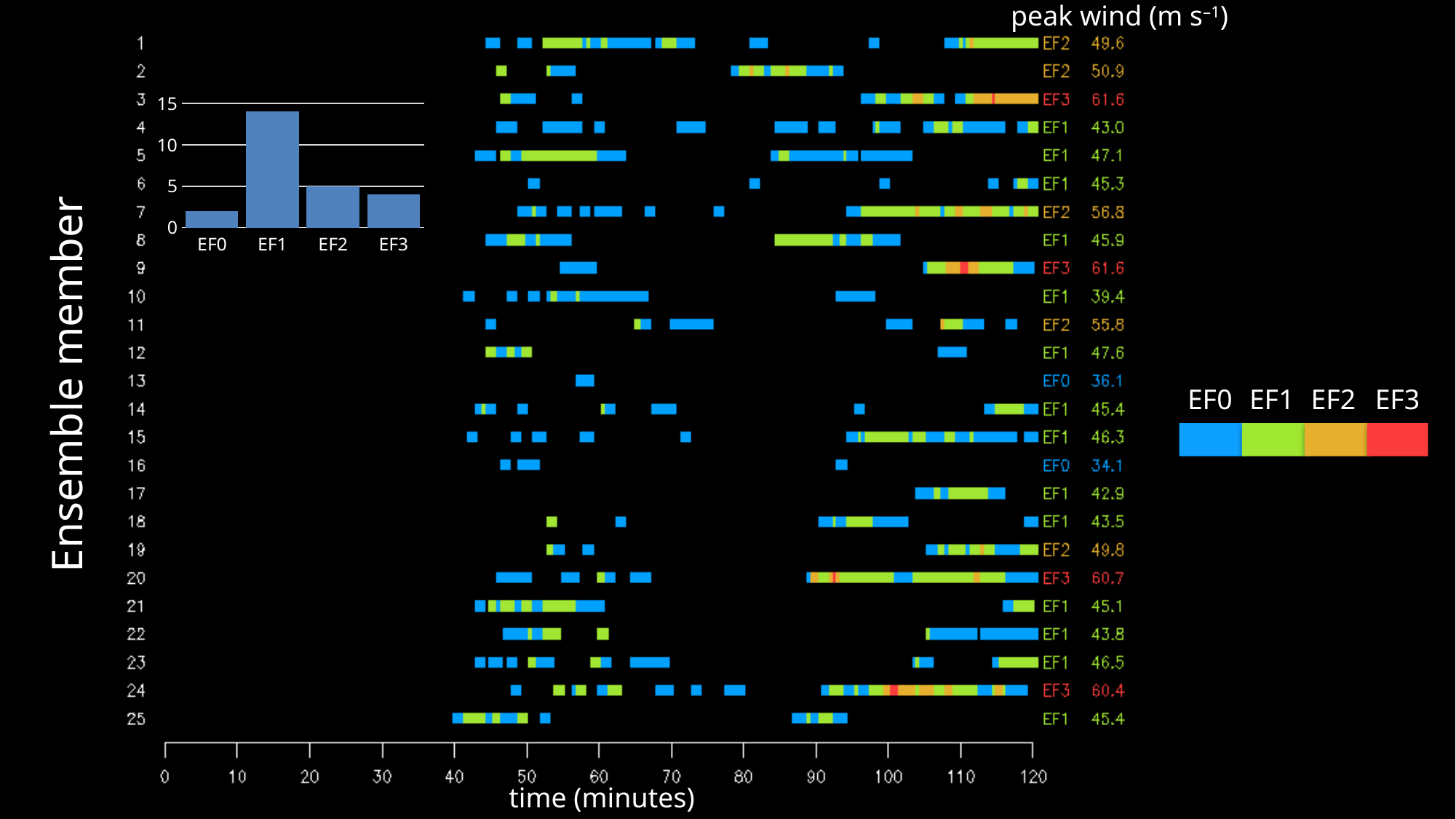
In the inset bar chart, how many categories are shown on the x axis? 4 In the main timeline chart, which ensemble member has the lowest peak wind? 16 In the main timeline chart, how many ensemble members are plotted on the y axis? 25 In the main timeline chart, what EF rating is listed for ensemble member 20? EF3 In the inset bar chart, which EF category has the tallest bar? EF1 What kind of chart is the small inset chart at the top left of the slide? bar chart In the inset bar chart, is the value for EF1 greater or less than 10? greater In the main timeline chart, what is the difference in peak wind between ensemble member 2 and ensemble member 1? 1.3 In the main timeline chart, what is the peak wind (m s⁻¹) for ensemble member 3? 61.6 In the inset bar chart, is the value for EF3 greater or less than 5? less In the inset bar chart, which EF category has the shortest bar? EF0 In the main timeline chart, which has the larger peak wind, ensemble member 20 or ensemble member 24? ensemble member 20